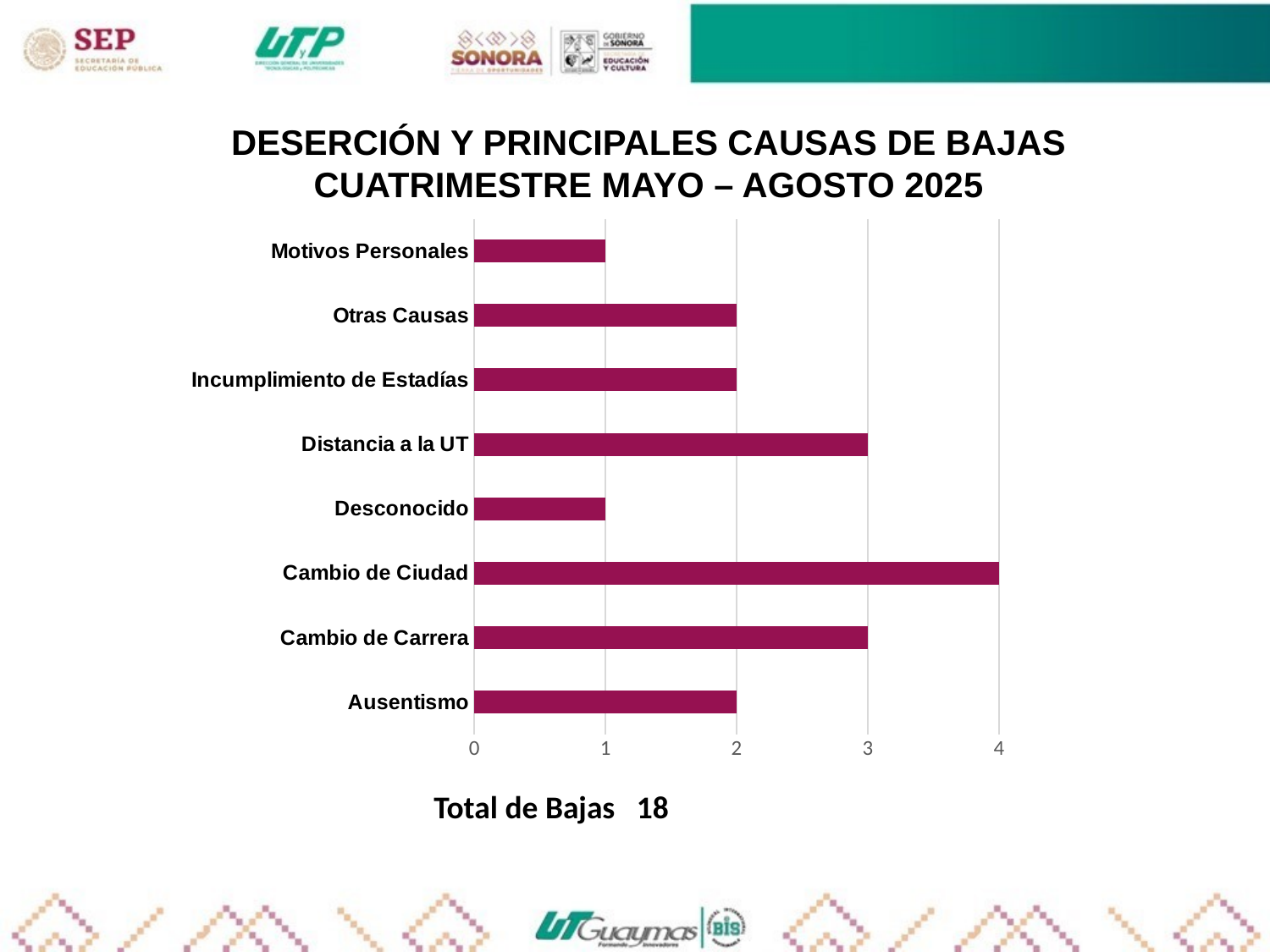
What type of chart is shown on the slide? bar chart What is the total number of bajas stated below the chart? 18 Is the value for Cambio de Ciudad greater or less than 3? greater Which cause has the highest value in the chart? Cambio de Ciudad How many categories (causes) are plotted in the chart? 8 What is the value for Distancia a la UT? 3 What is the value for Ausentismo? 2 What is the value for Desconocido? 1 Which is larger, the value for Cambio de Carrera or the value for Otras Causas? Cambio de Carrera What is the title of the chart? DESERCIÓN Y PRINCIPALES CAUSAS DE BAJAS CUATRIMESTRE MAYO – AGOSTO 2025 What is the value for Cambio de Ciudad? 4 What is the difference between the values for Cambio de Ciudad and Motivos Personales? 3